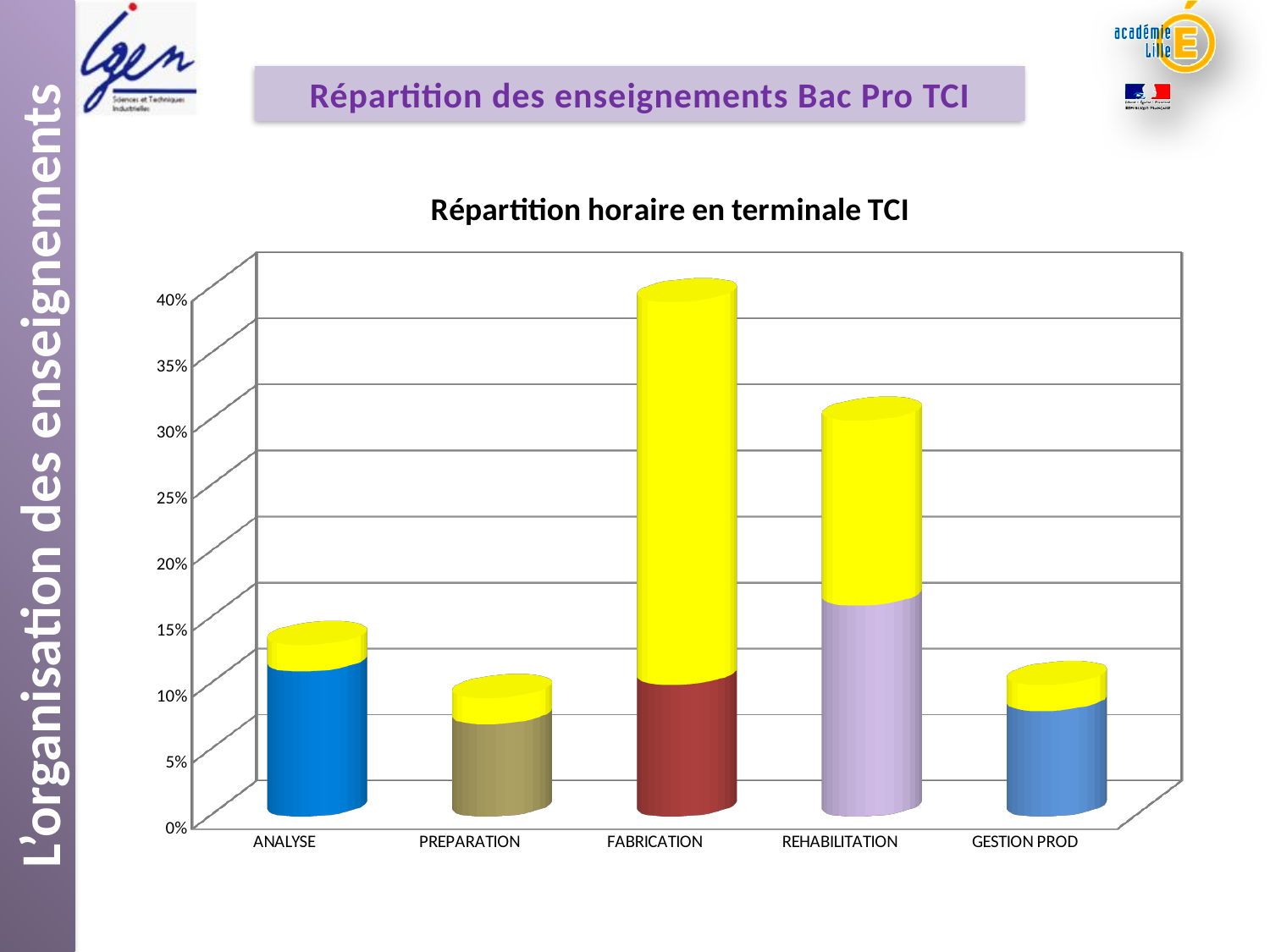
Is the bar for REHABILITATION greater or less than 25%? greater How many categories are shown on the x axis of the chart? 5 Is the bar for GESTION PROD greater or less than 20%? less What kind of chart is shown on the slide? bar chart What colour is the top segment of every bar in the chart? yellow Which category has the highest bar in the chart? FABRICATION Is the bar for ANALYSE greater or less than 20%? less Which bar is taller, ANALYSE or PREPARATION? ANALYSE Which bar is taller, FABRICATION or REHABILITATION? FABRICATION What is the title of the chart? Répartition horaire en terminale TCI